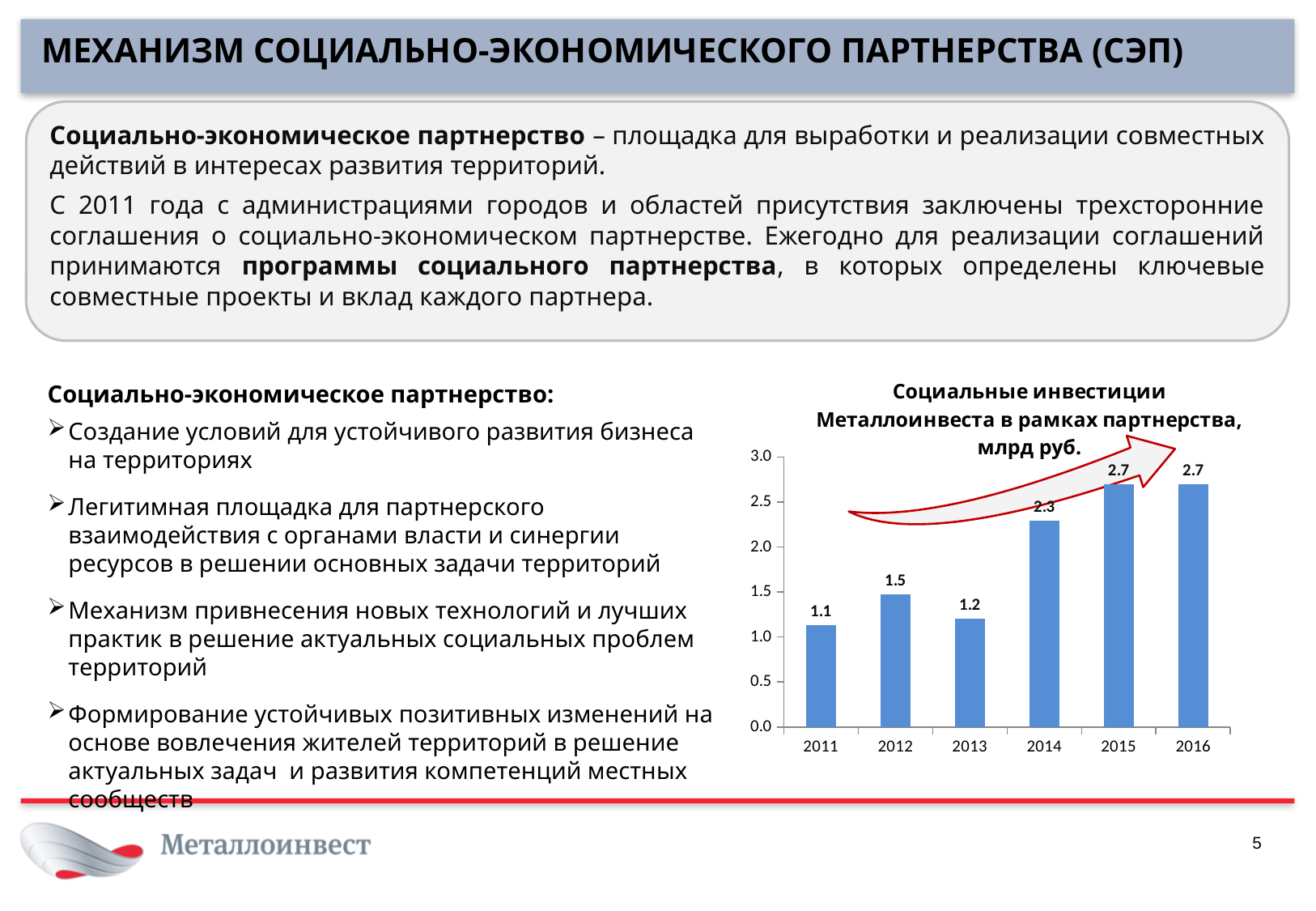
Is the value for 2014 greater or less than 2.0? greater Which year has the lowest value in the chart? 2011 What is the difference between the values for 2014 and 2013? 1.1 What is the value for 2014 in the chart of social investments? 2.3 What is the difference between the values for 2015 and 2011? 1.6 What type of chart is shown on the slide? Bar chart What is the value for 2016 in the chart of social investments? 2.7 How many years are shown on the x axis of the chart? 6 What is the value for 2012 in the chart of social investments? 1.5 What unit is given in the chart title for the social investments? млрд руб. Which is larger, the value for 2012 or the value for 2013? 2012 What is the value for 2011 in the chart of social investments? 1.1